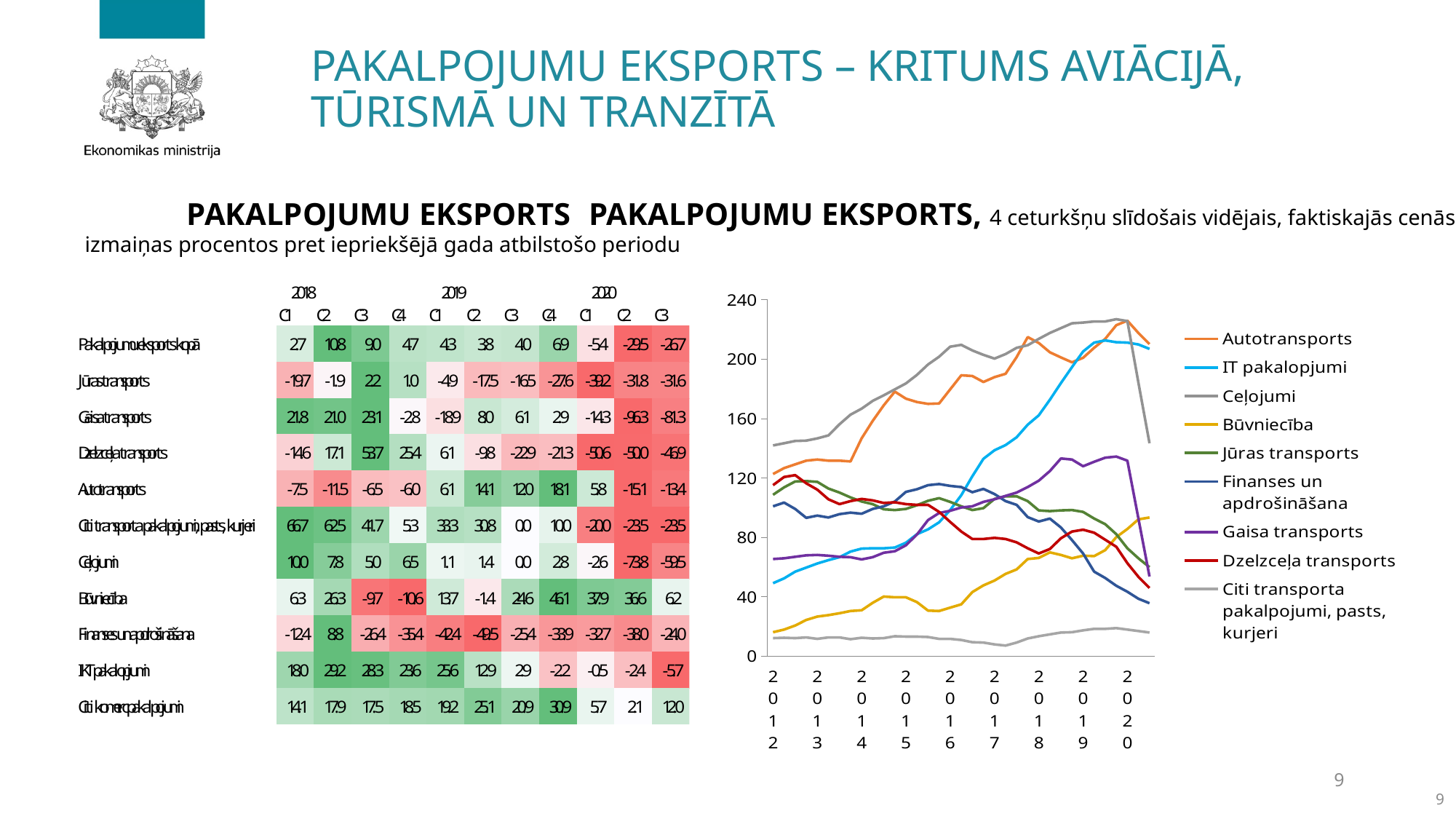
How many years are labelled on the x axis of the line chart? 9 What is the highest value shown on the y axis of the line chart? 240 In the line chart, which series stays lowest across the whole period? Citi transporta pakalpojumi, pasts, kurjeri In the line chart, is the value for Ceļojumi in 2012 greater or less than 120? greater In the line chart, is the value for IT pakalpojumi in 2012 greater or less than 80? less In the line chart, is the value for Gaisa transports at the end of 2020 greater or less than 120? less In the line chart, which is larger in 2012: Ceļojumi or IT pakalpojumi? Ceļojumi What kind of chart is shown on the right side of the slide? line chart How many series does the legend of the line chart list? 9 In the line chart, does the IT pakalpojumi series rise or fall from 2012 to 2019? rise In the line chart, which is larger at the end of 2020: Autotransports or Gaisa transports? Autotransports